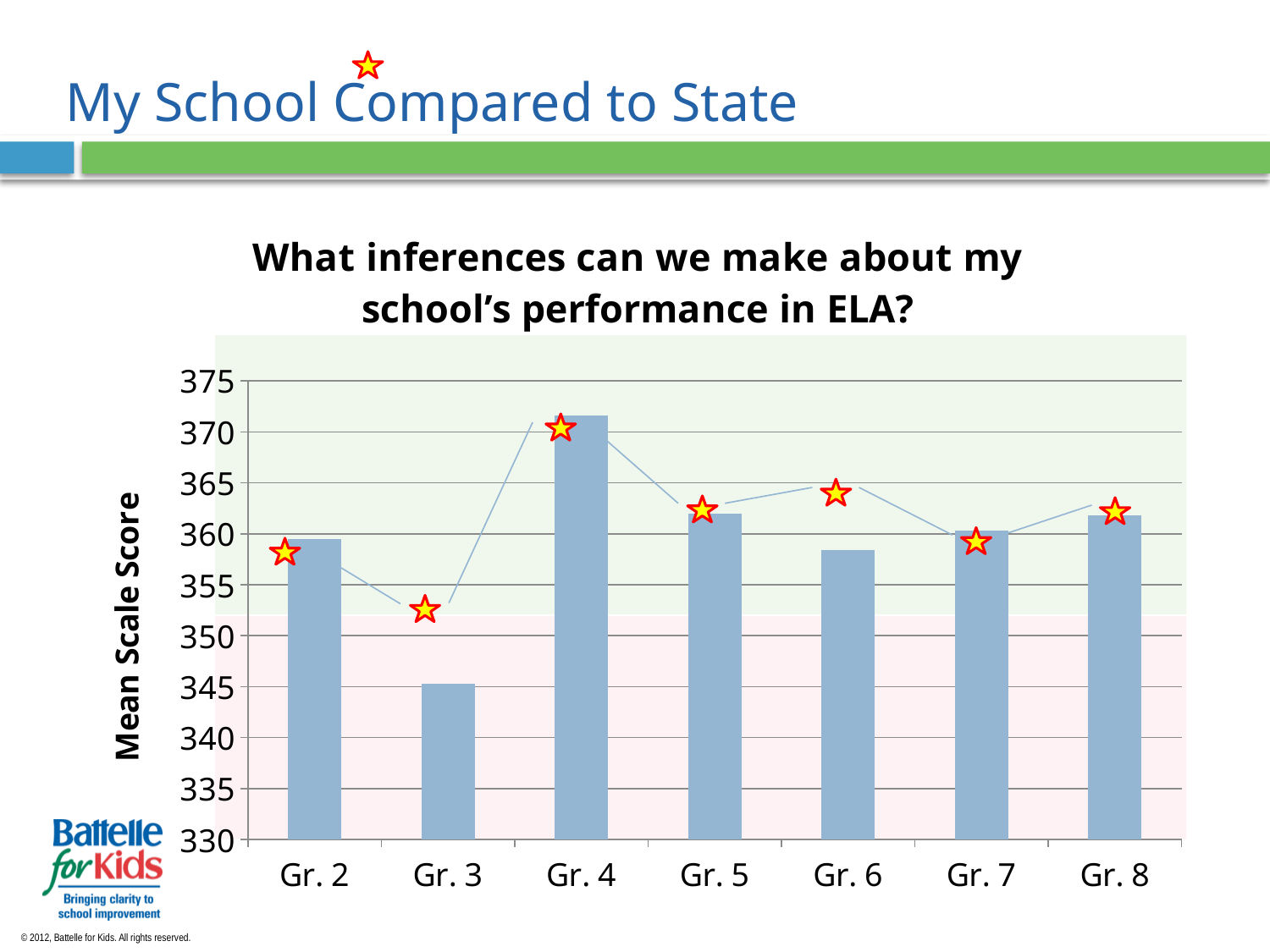
Which grade has the lowest mean scale score bar? Gr. 3 Which bar is taller, Gr. 2 or Gr. 3? Gr. 2 Is the value for Gr. 2 greater or less than 355? greater What is the label on the vertical axis of the chart? Mean Scale Score Is the value for Gr. 6 greater or less than 360? less What is the title of the chart? What inferences can we make about my school's performance in ELA? Is the value for Gr. 4 greater or less than 365? greater How many grade categories are shown on the x axis of the chart? 7 Which grade has the highest mean scale score bar? Gr. 4 What kind of chart is shown on the slide? bar chart Which bar is taller, Gr. 5 or Gr. 6? Gr. 5